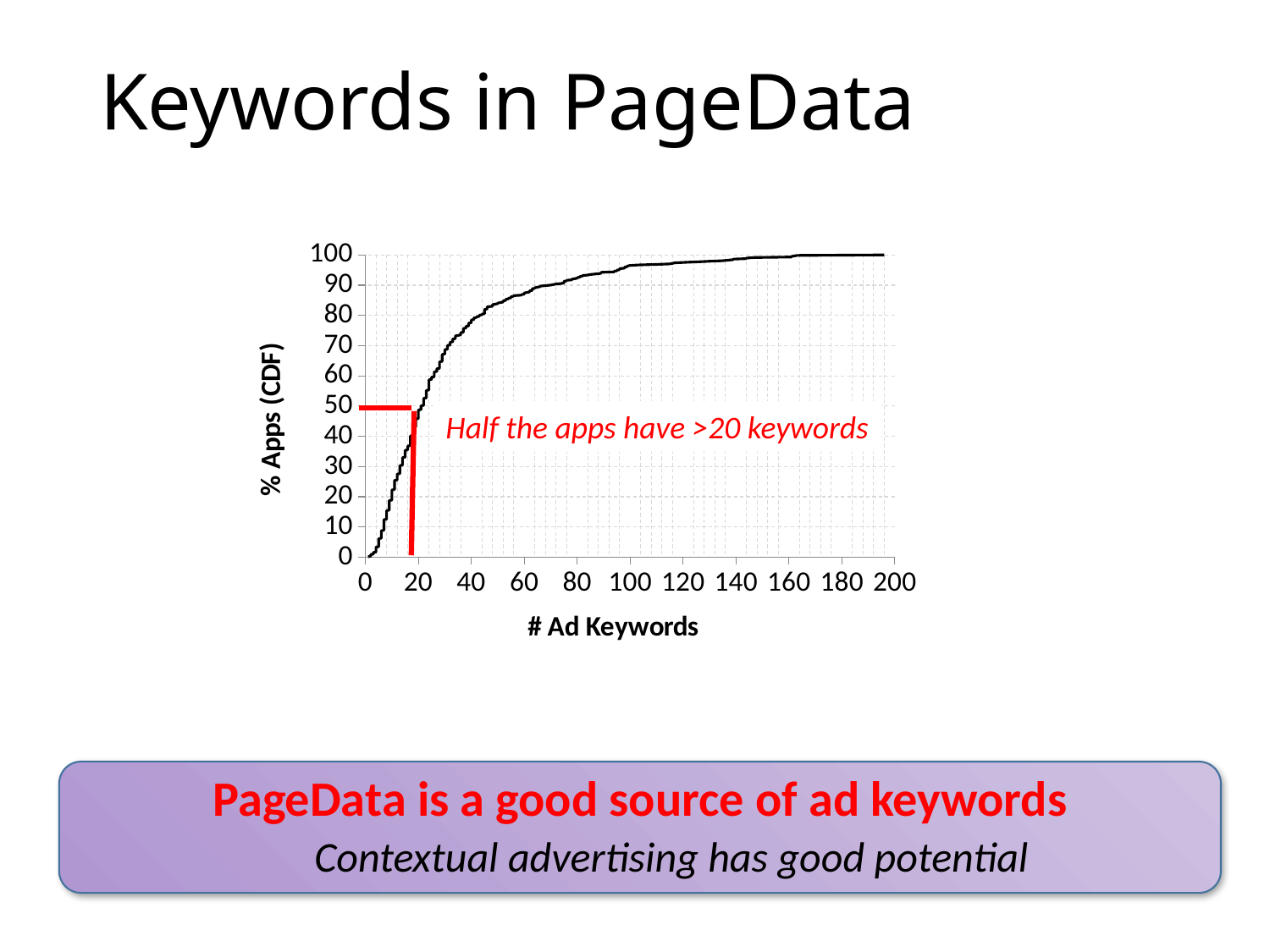
Does the plotted line rise or fall as the number of ad keywords increases? rise What is the highest value shown on the y axis of the chart? 100 Is the % Apps (CDF) value at 60 ad keywords greater or less than 80? greater What is the label of the x axis of the chart? # Ad Keywords According to the annotation on the chart, what percentage of apps have more than 20 keywords? Half Is the % Apps (CDF) value at 10 ad keywords greater or less than 40? less Is the % Apps (CDF) value at 100 ad keywords greater or less than 90? greater What kind of chart is shown on the slide? line chart What is the highest value shown on the x axis of the chart? 200 Which is larger: the % Apps (CDF) value at 20 ad keywords or at 80 ad keywords? 80 ad keywords What is the label of the y axis of the chart? % Apps (CDF)